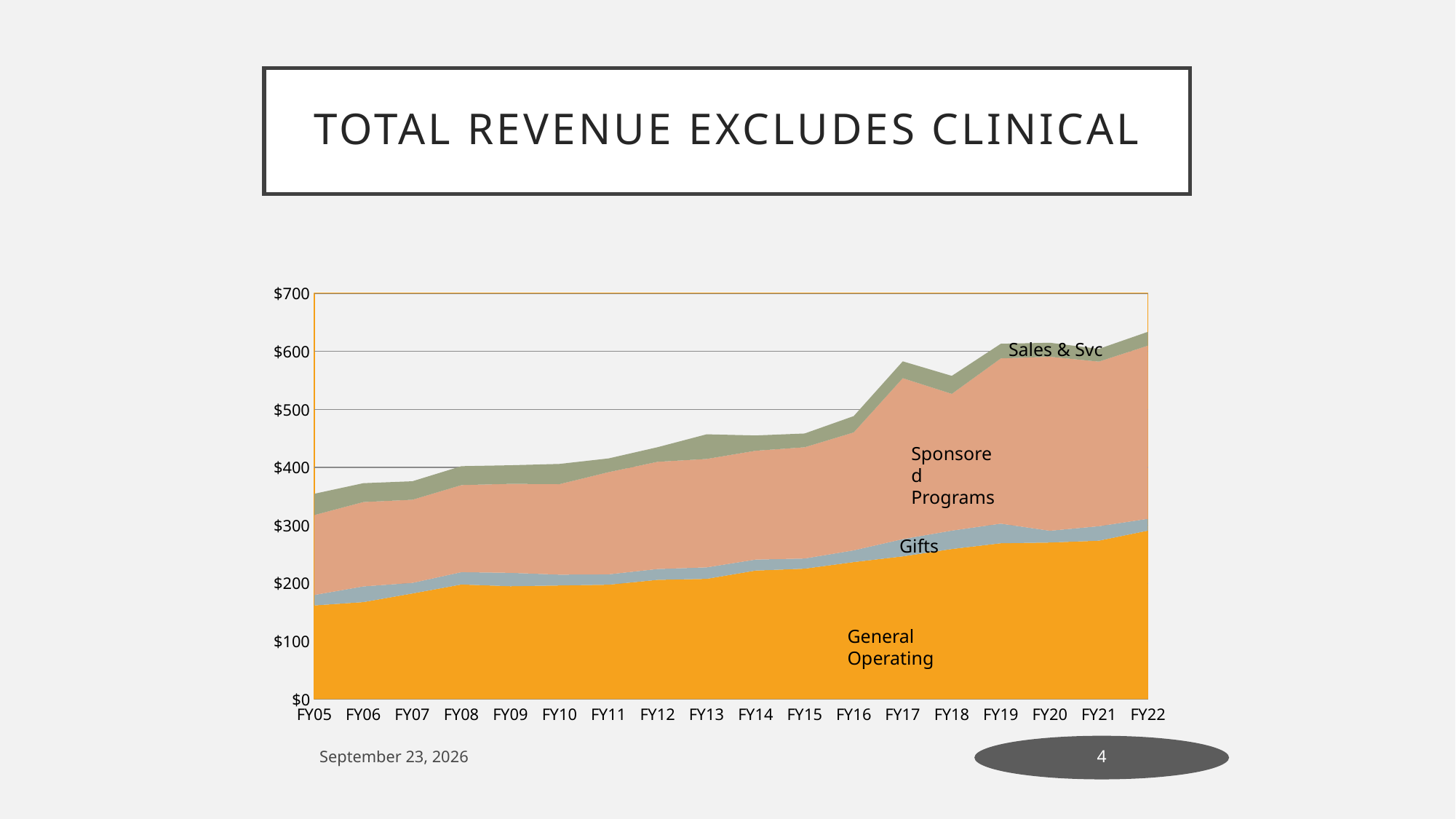
Is the General Operating value in FY05 greater or less than $200? less Which revenue category forms the bottom (orange) layer of the stacked area? General Operating Is the total revenue in FY17 greater or less than $500? greater Is the total revenue in FY18 greater or less than $600? less What is the title of the slide containing the chart? TOTAL REVENUE EXCLUDES CLINICAL What kind of chart is shown on the slide? Stacked area chart How many revenue categories are labeled in the chart? 4 Which year has the higher total revenue, FY17 or FY18? FY17 How many fiscal years are plotted along the x axis? 18 Does total revenue generally rise or fall from FY05 to FY22? rise